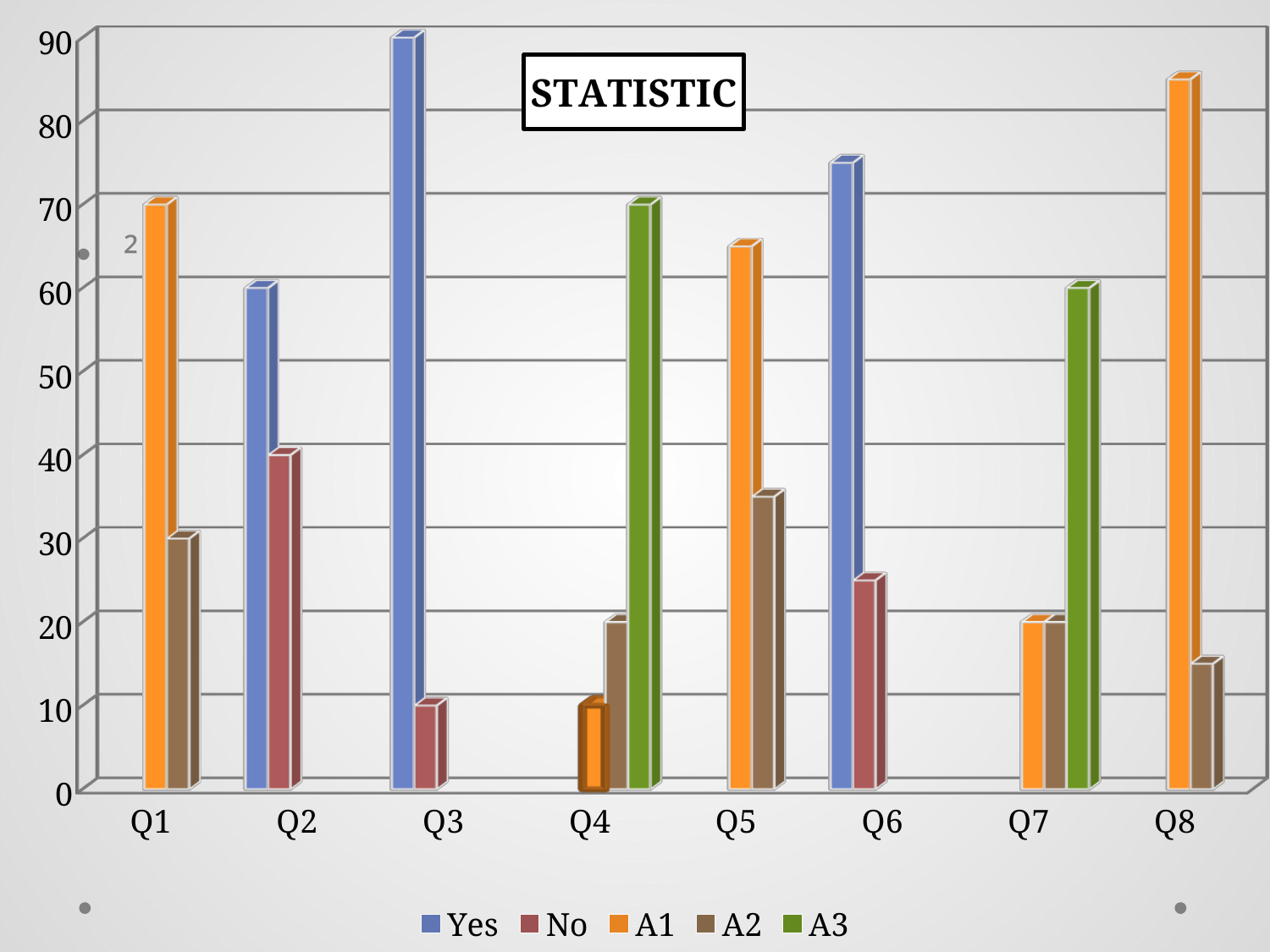
How many series does the legend list? 5 Which is larger for Q4: the A3 bar or the A2 bar? A3 How many categories are shown on the x axis? 8 Is the value of the No series for Q6 greater or less than 30? less What is the value of the A1 series for Q1? 70 What is the value of the No series for Q2? 40 Which category has the tallest Yes bar? Q3 Is the value of the A1 series for Q8 greater or less than 80? greater What is the value of the Yes series for Q3? 90 What is the title of the chart? STATISTIC What is the value of the A3 series for Q7? 60 What kind of chart is shown on the slide? bar chart